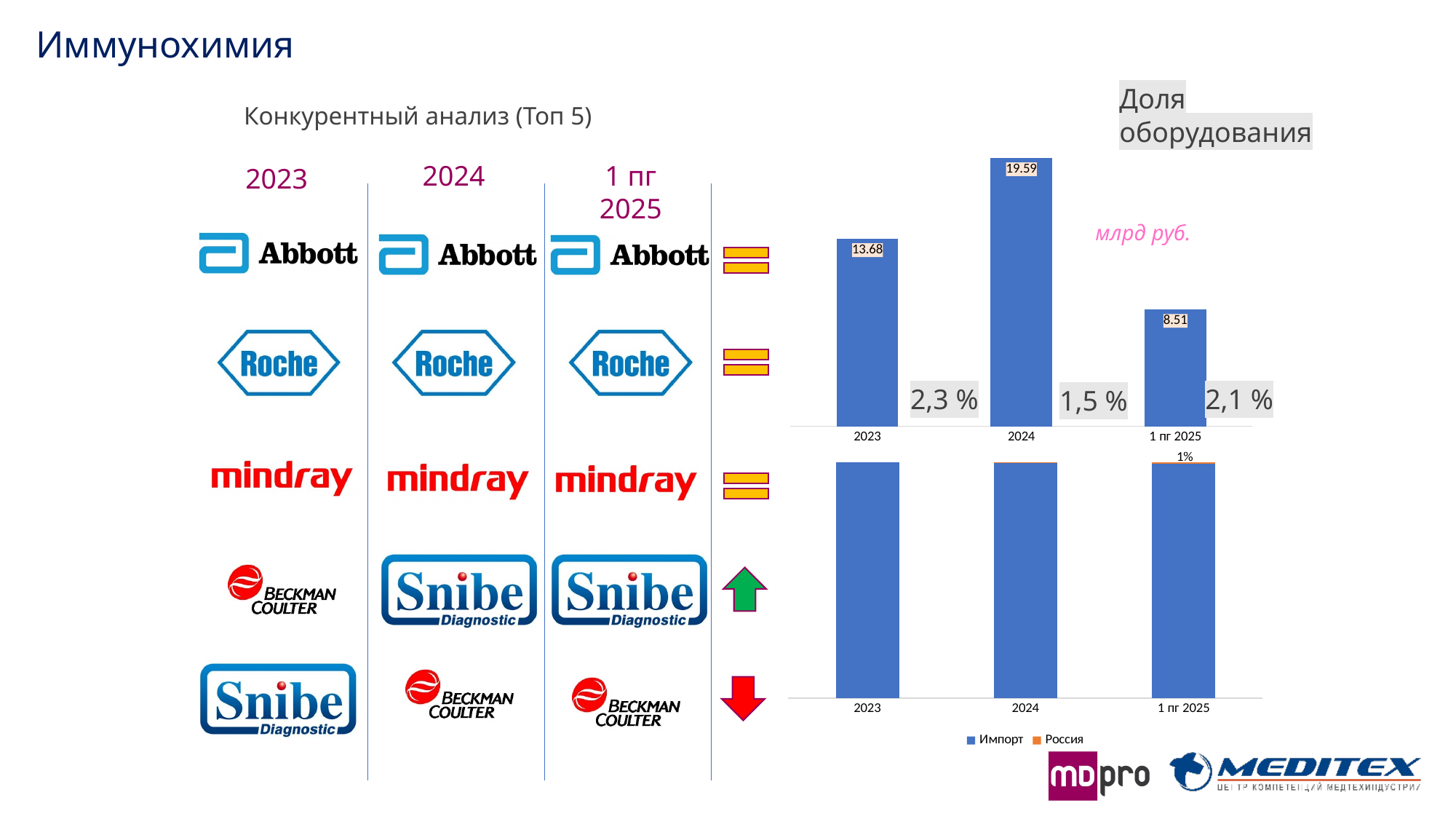
How many bars are in the top bar chart? 3 In the top bar chart, what is the difference between the 2024 and 2023 values? 5.91 In the top bar chart, what is the value for 1 пг 2025? 8.51 In the top bar chart, which period has the lowest value? 1 пг 2025 In the top bar chart, which is larger, the value for 2023 or the value for 1 пг 2025? 2023 How many series does the legend of the bottom chart list? 2 In the bottom stacked bar chart, what is the labelled share of Россия for 1 пг 2025? 1% What are the two series named in the legend of the bottom chart? Импорт and Россия In the top bar chart, which period has the highest value? 2024 In the top bar chart, what is the value for 2024? 19.59 In the top bar chart, what is the value for 2023? 13.68 What type of chart is the top chart on the slide? bar chart